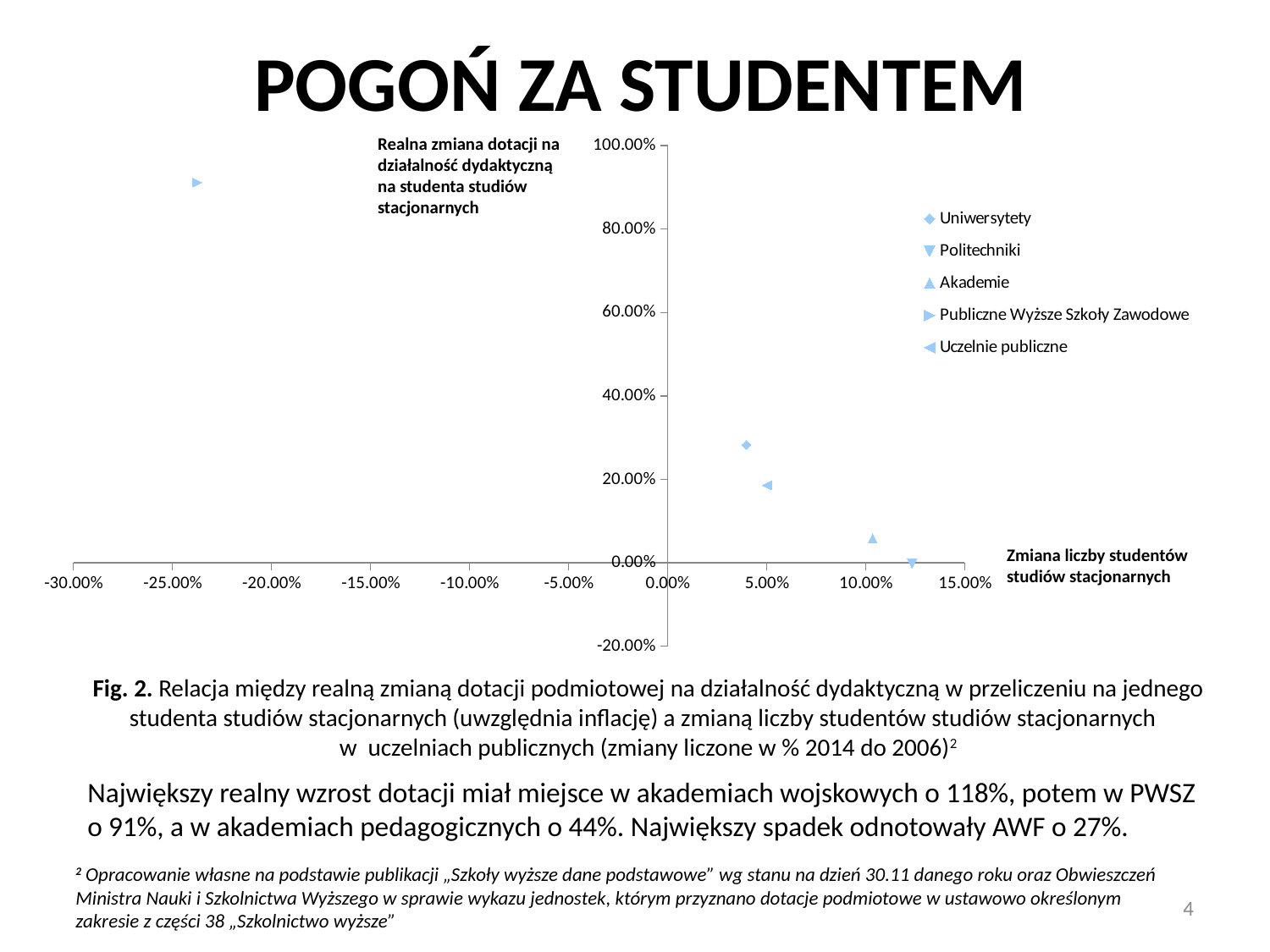
Which has the larger vertical-axis value, Uniwersytety or Akademie? Uniwersytety Is the horizontal-axis value for Politechniki greater or less than 10.00%? greater How many series does the legend list? 5 Is the vertical-axis value for Uniwersytety greater or less than 20.00%? greater What is the label of the horizontal axis of the chart? Zmiana liczby studentów studiów stacjonarnych What kind of chart is shown on the slide? scatter chart Which series has the lowest value on the vertical axis? Politechniki Is the horizontal-axis value for Publiczne Wyższe Szkoły Zawodowe greater or less than -20.00%? less How many data points are plotted on the chart? 5 Which series has the highest value on the vertical axis (real change in subsidy per student)? Publiczne Wyższe Szkoły Zawodowe